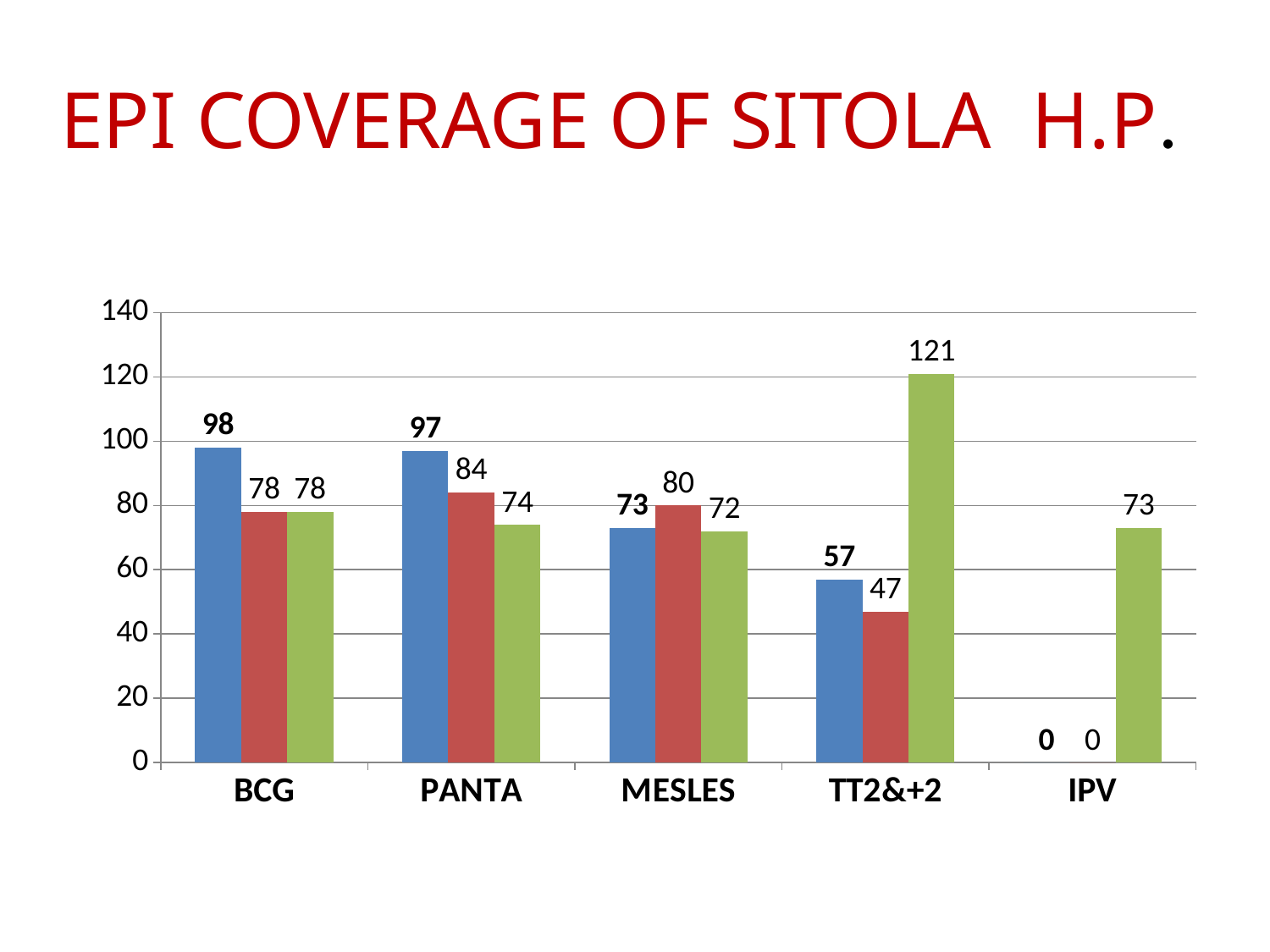
What kind of chart is shown on the slide? bar chart How many categories are shown on the x axis? 5 Which category has the highest blue bar? BCG Do the blue bars rise or fall from BCG to IPV? fall What is the value of the green bar for IPV? 73 What is the difference between the blue bar and the red bar for PANTA? 13 Which category has the lowest red bar? IPV What is the value of the green bar for TT2&+2? 121 What is the title of the slide? EPI COVERAGE OF SITOLA H.P. What is the value of the blue bar for BCG? 98 What is the value of the red bar for MESLES? 80 Which is larger for TT2&+2, the blue bar or the red bar? the blue bar